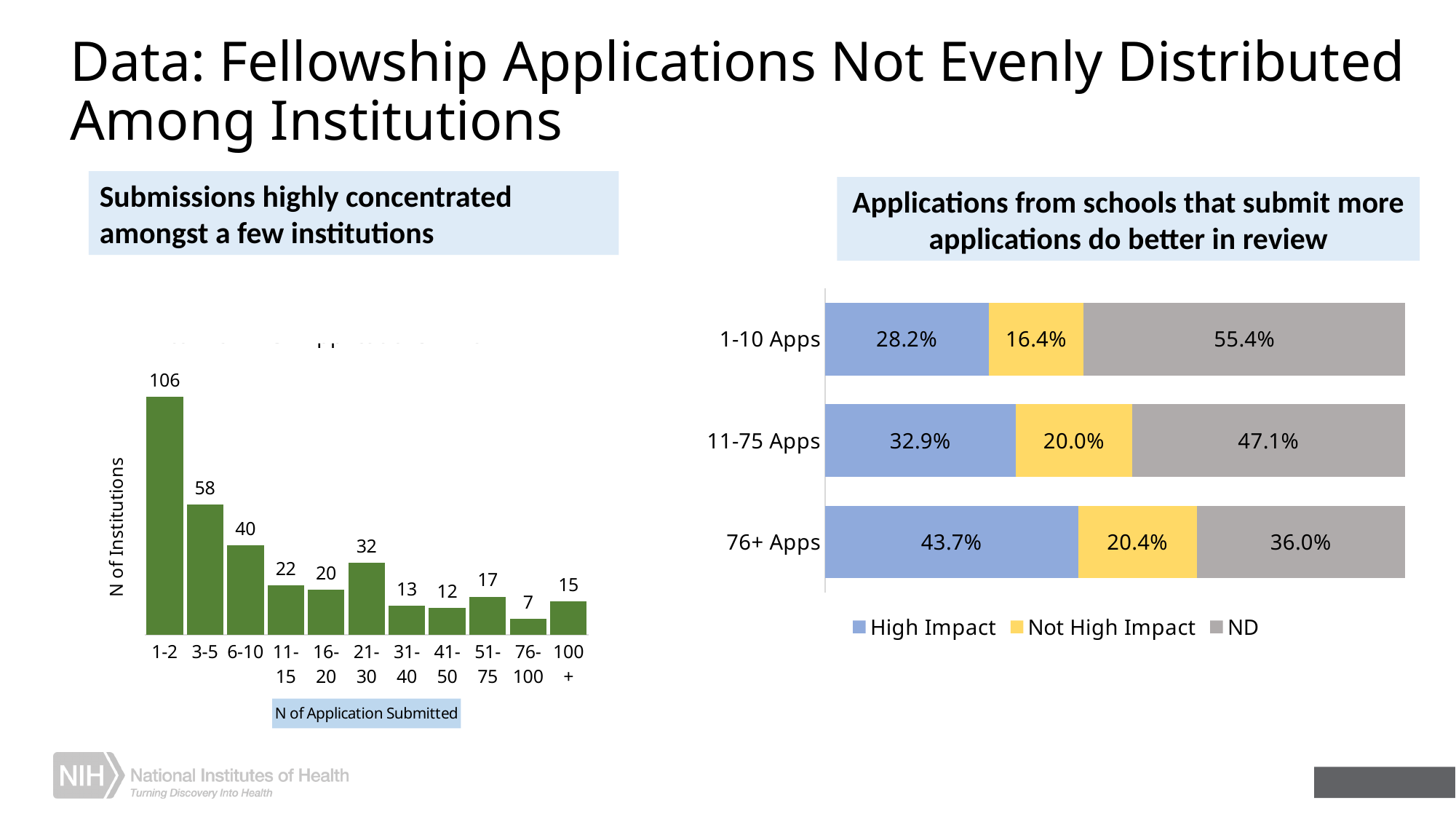
In the left chart, how many application-count categories are shown on the x axis? 11 What kind of chart is the left chart? bar chart In the right chart, what is the ND percentage for the 1-10 Apps group? 55.4% In the right chart, what is the difference between the ND percentage for 1-10 Apps and for 76+ Apps? 19.4% In the left chart, what is the difference between the number of institutions submitting 1-2 applications and those submitting 3-5 applications? 48 In the left chart, which application-count category has the fewest institutions? 76-100 In the right chart, which group has the highest High Impact percentage? 76+ Apps In the right chart, what percentage of applications from schools submitting 76+ apps were High Impact? 43.7% In the right chart, how many series does the legend list? 3 In the left chart, how many institutions submitted 21-30 applications? 32 In the left chart, how many institutions submitted 1-2 applications? 106 In the left chart, which application-count category has the most institutions? 1-2